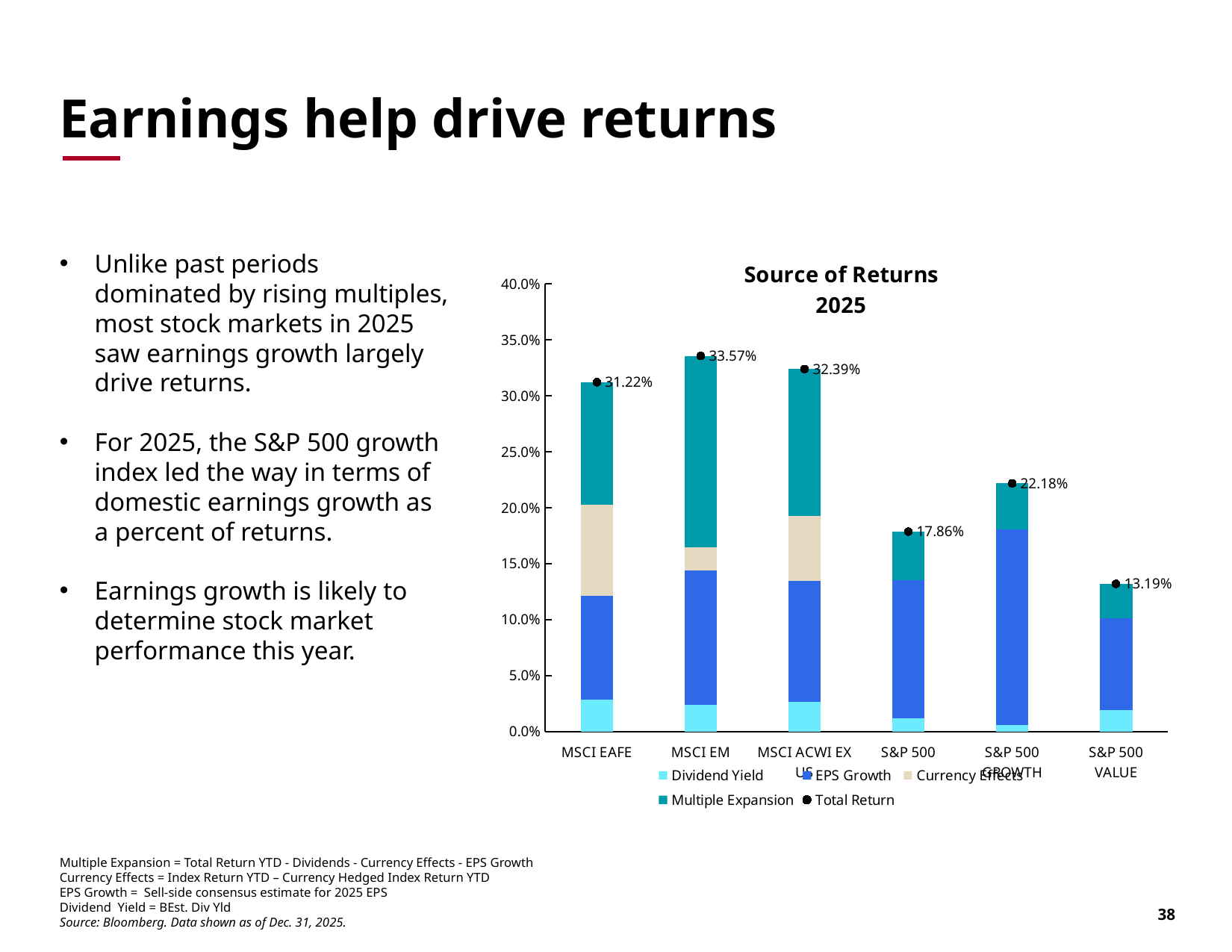
What is the Total Return for MSCI ACWI EX US? 32.39% Which index has the lowest Total Return? S&P 500 VALUE What type of chart is shown? Stacked bar chart How many indices are shown on the x axis? 6 What is the Total Return for MSCI EM? 33.57% What is the Total Return for S&P 500 VALUE? 13.19% What is the difference in Total Return between MSCI EM and MSCI EAFE? 2.35 percentage points Which has a higher Total Return, S&P 500 or S&P 500 GROWTH? S&P 500 GROWTH What is the Total Return for S&P 500 GROWTH? 22.18% Is the EPS Growth segment for S&P 500 GROWTH greater or less than 15.0%? greater Which index has the highest Total Return? MSCI EM How many entries does the legend list? 5